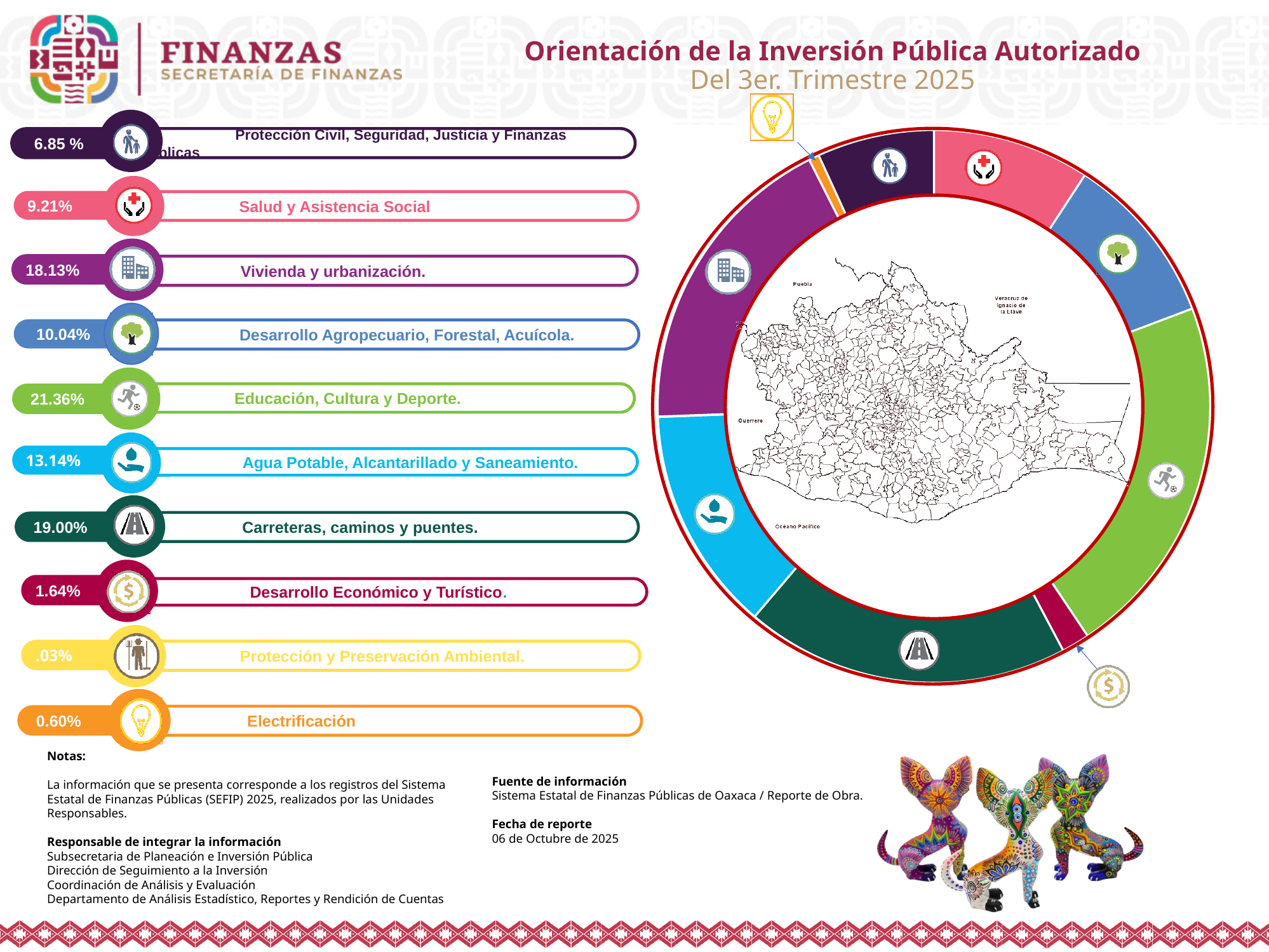
What is the value for Electrificación? 0.60% Which category has the lowest share? Protección y Preservación Ambiental What is the title of the chart on the slide? Orientación de la Inversión Pública Autorizado Del 3er. Trimestre 2025 What kind of chart is shown on the slide? Pie (donut) chart Which is larger, the share of Vivienda y urbanización or the share of Carreteras, caminos y puentes? Carreteras, caminos y puentes What is the value for Educación, Cultura y Deporte? 21.36% How many categories does the chart show? 10 What is the difference between the shares of Educación, Cultura y Deporte and Carreteras, caminos y puentes? 2.36 percentage points What is the value for Carreteras, caminos y puentes? 19.00% What is the value for Vivienda y urbanización? 18.13% What is the value for Agua Potable, Alcantarillado y Saneamiento? 13.14% Which category has the highest share? Educación, Cultura y Deporte